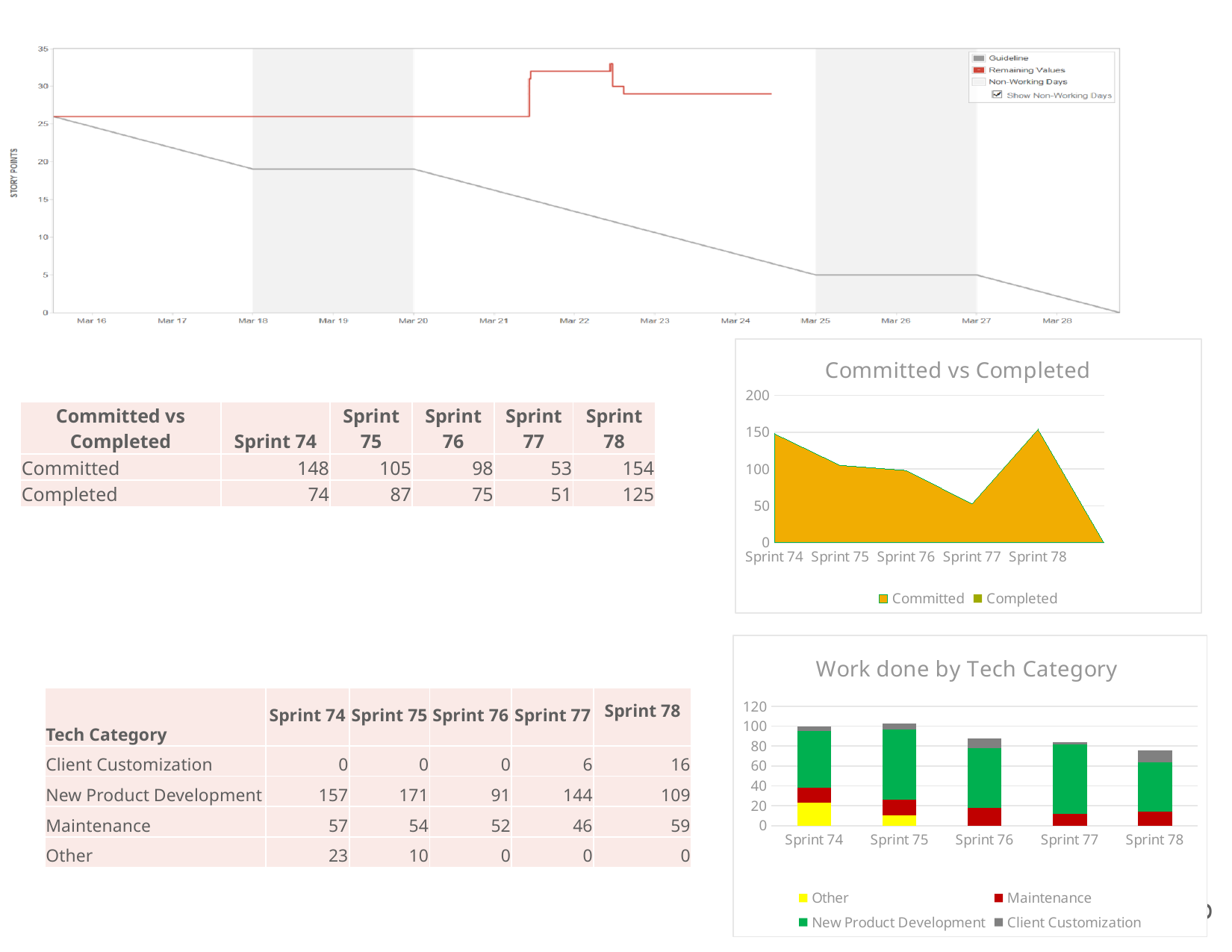
In the 'Work done by Tech Category' chart, is the total for Sprint 78 greater or less than 80? less In the 'Work done by Tech Category' chart, which colour represents the 'Other' category? yellow In the 'Work done by Tech Category' chart, which sprint has the lowest total stacked bar? Sprint 78 What kind of chart is the 'Work done by Tech Category' chart? bar chart How many sprints are shown on the x axis of the 'Work done by Tech Category' chart? 5 In the 'Committed vs Completed' chart, which sprint has the lowest Committed value? Sprint 77 How many series does the legend of the 'Work done by Tech Category' chart list? 4 How many series does the legend of the 'Committed vs Completed' chart list? 2 In the top burndown chart, does the Guideline series rise or fall from Mar 16 to Mar 28? fall In the 'Committed vs Completed' chart, is the Committed value for Sprint 74 greater or less than 100? greater In the 'Committed vs Completed' chart, is the Committed value for Sprint 77 greater or less than 100? less